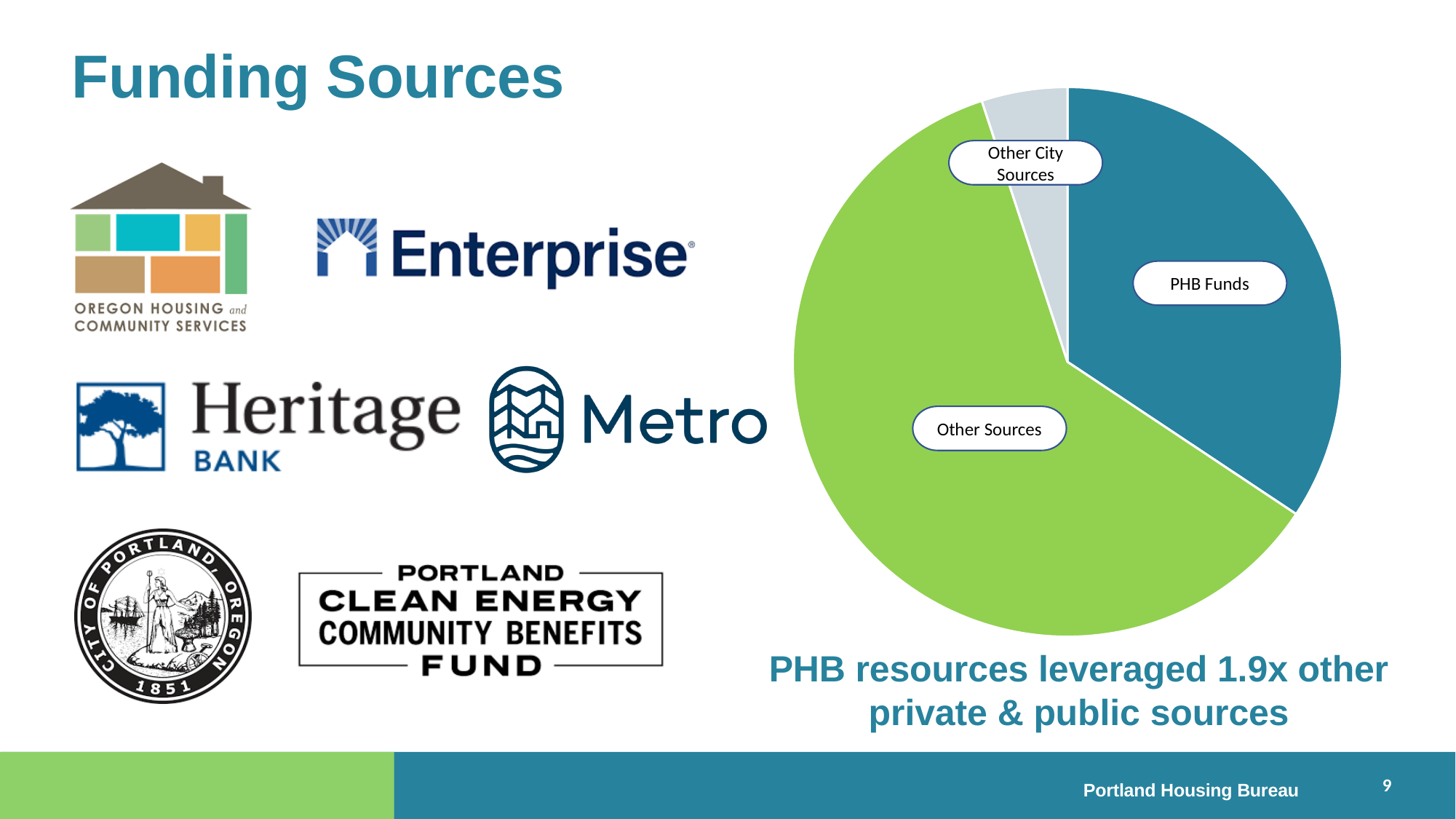
What colour is the Other Sources slice of the pie chart? green What colour is the PHB Funds slice of the pie chart? blue Which slice of the pie chart is the smallest? Other City Sources How many slices does the pie chart have? 3 Which is larger in the pie chart, Other Sources or PHB Funds? Other Sources Which is larger in the pie chart, PHB Funds or Other City Sources? PHB Funds Which is larger in the pie chart, Other City Sources or Other Sources? Other Sources What kind of chart is shown on the slide? pie chart Which slice of the pie chart is the largest? Other Sources